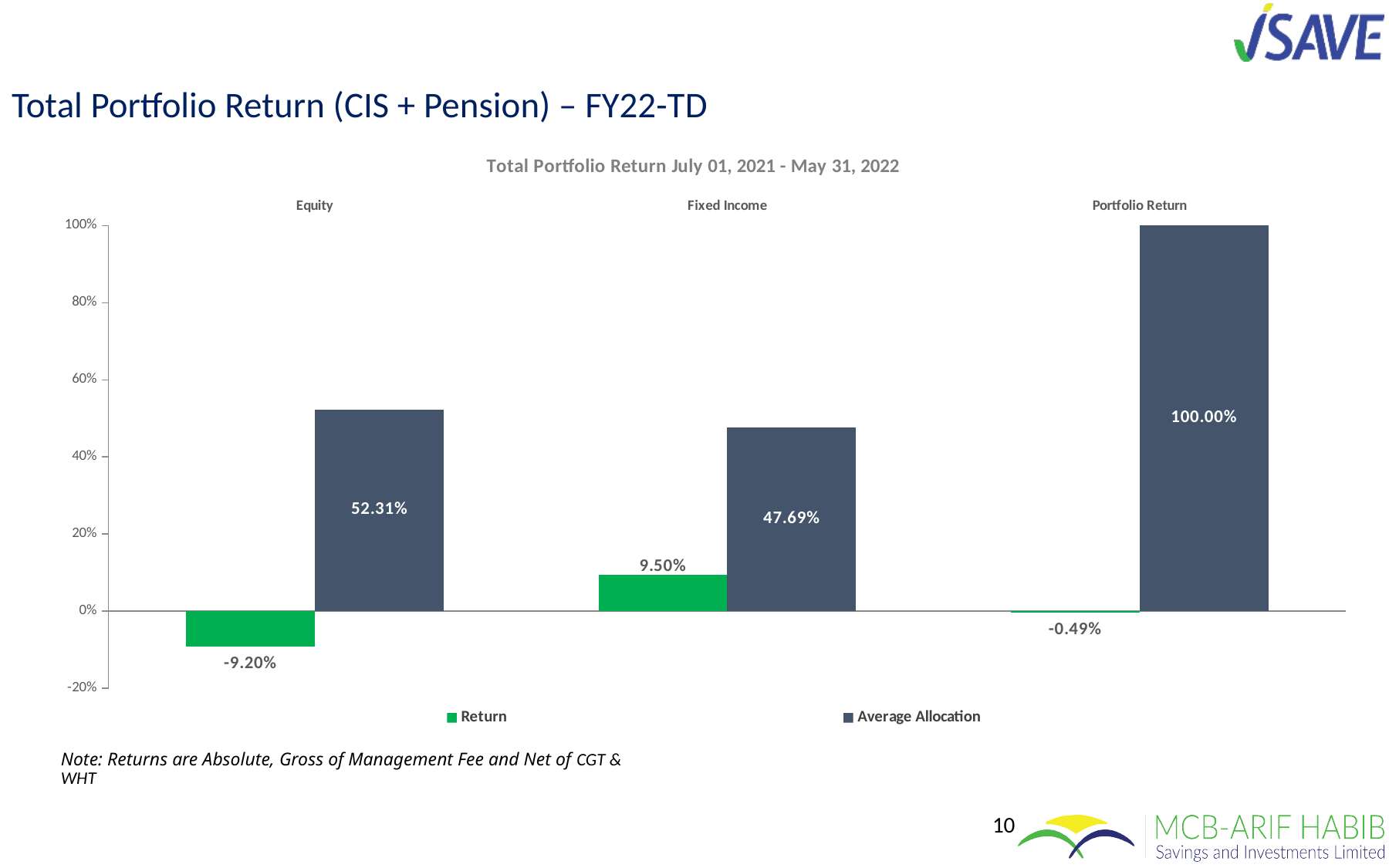
What is the title of the chart? Total Portfolio Return July 01, 2021 - May 31, 2022 How many series does the legend list? 2 What is the Return shown for Portfolio Return? -0.49% What kind of chart is shown on the slide? Bar chart What is the Return for Equity? -9.20% What is the Average Allocation for Fixed Income? 47.69% Which is larger, the Average Allocation for Equity or for Fixed Income? Equity Which category has the lowest Return? Equity What is the Return for Fixed Income? 9.50% What is the difference between the Average Allocation for Equity and for Fixed Income? 4.62% Which category has the highest Return? Fixed Income What is the Average Allocation for Equity? 52.31%